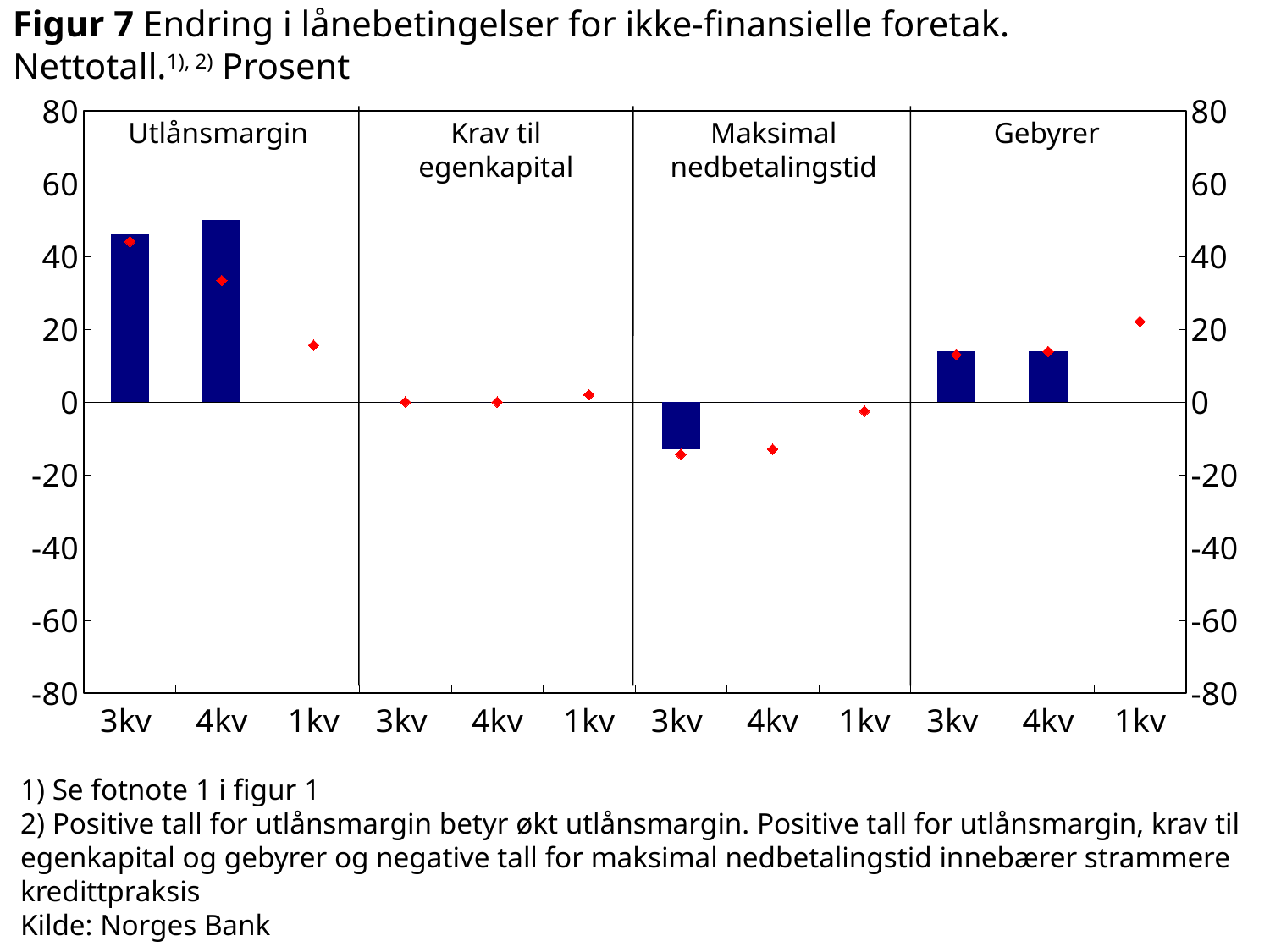
Is the value for Utlånsmargin in 3kv greater or less than 40? greater Which panel and quarter has the highest value in the chart? Utlånsmargin, 4kv How many quarters are shown within each panel of the chart? 3 What is the source given for the chart? Norges Bank Is the value for Utlånsmargin in 1kv greater or less than 20? less How many lending-condition categories (panels) does the chart show? 4 Is the value for Gebyrer in 3kv greater or less than 20? less Which is larger: the 3kv value for Utlånsmargin or the 3kv value for Gebyrer? Utlånsmargin What kind of chart is shown in Figur 7? combination bar and line chart (bars with diamond markers) Which panel and quarter has the lowest value in the chart? Maksimal nedbetalingstid, 3kv